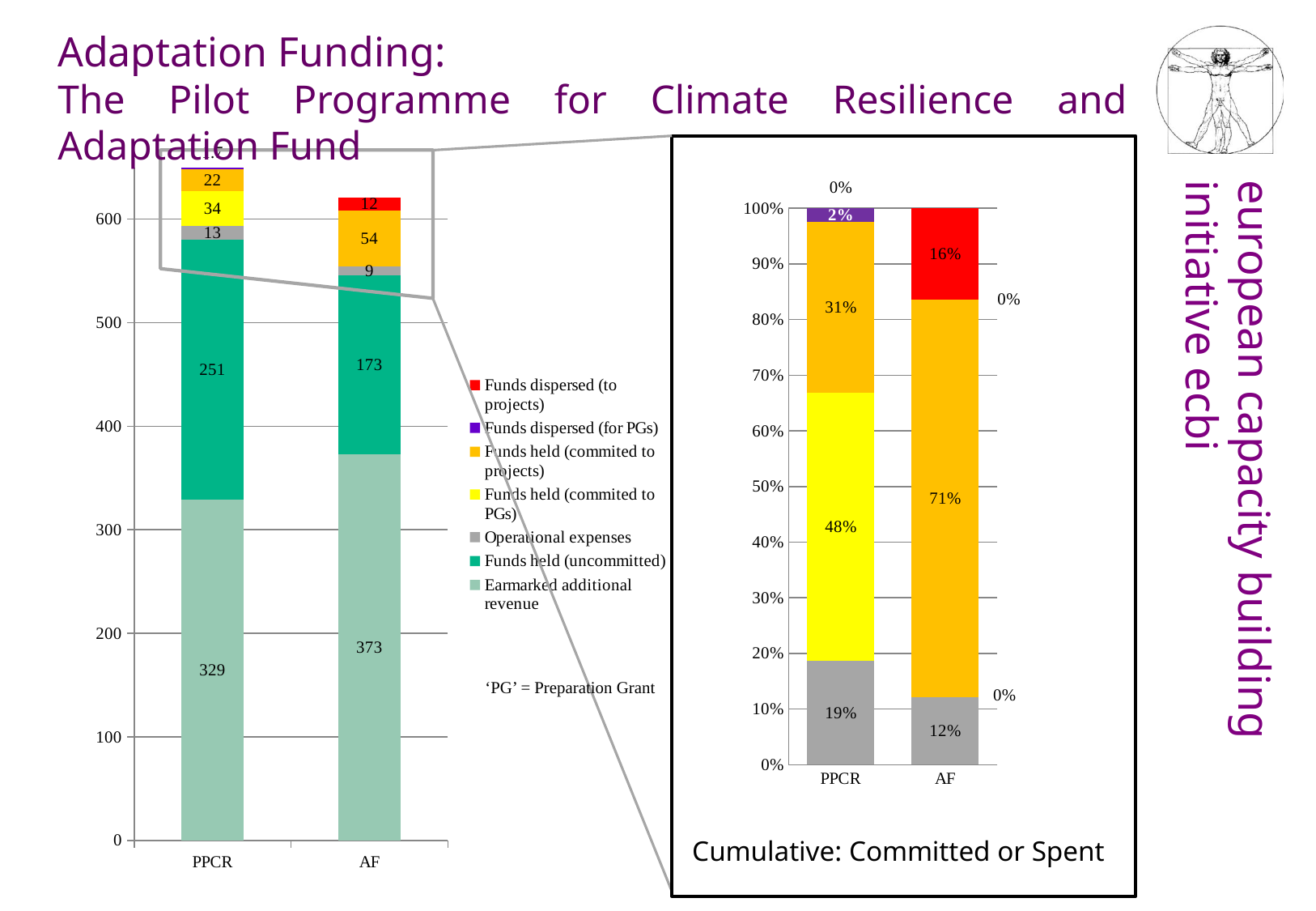
In the left stacked bar chart, what is the value of Operational expenses for PPCR? 13 What kind of chart is the left chart? Stacked bar chart In the left stacked bar chart, how much larger is Earmarked additional revenue for AF than for PPCR? 44 In the left stacked bar chart, what is the value of Earmarked additional revenue for PPCR? 329 In the 'Cumulative: Committed or Spent' chart, what percentage of AF is Funds dispersed (to projects)? 16% In the left stacked bar chart, what is the value of Funds held (uncommitted) for AF? 173 In the left stacked bar chart, what is the value of Funds held (commited to projects) for AF? 54 In the 'Cumulative: Committed or Spent' chart, what percentage of AF is Funds held (commited to projects)? 71% In the 'Cumulative: Committed or Spent' chart, what percentage of PPCR is Funds held (commited to PGs)? 48% How many categories are shown on the x axis of the 'Cumulative: Committed or Spent' chart? 2 How many series does the legend of the left stacked bar chart list? 7 In the left stacked bar chart, which fund has the larger value for Funds held (uncommitted), PPCR or AF? PPCR